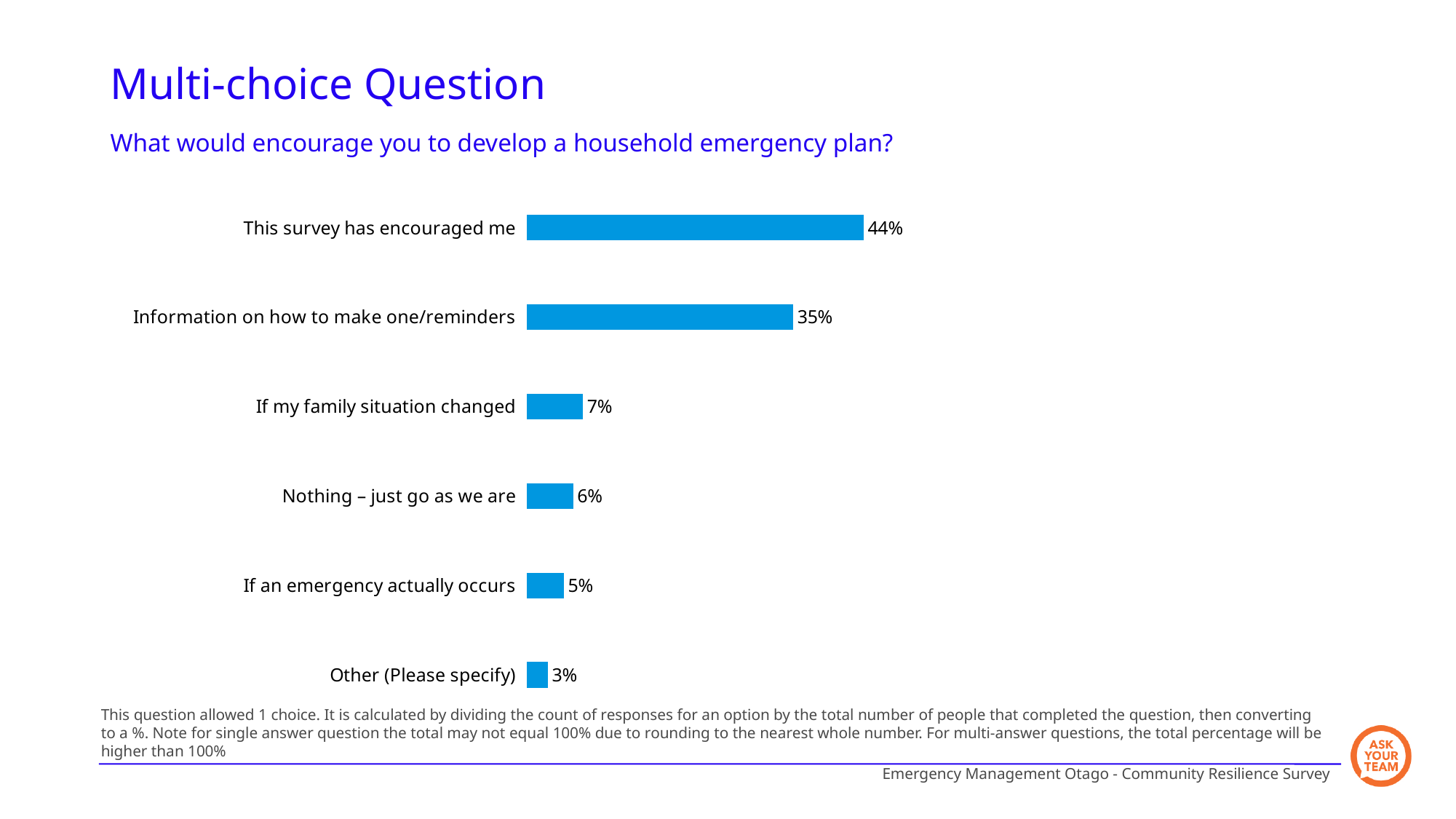
What is the value for "Information on how to make one/reminders"? 35% What percentage is shown for "If my family situation changed"? 7% What percentage of respondents chose "This survey has encouraged me"? 44% Which option has the highest percentage? This survey has encouraged me What survey question does the chart present responses to? What would encourage you to develop a household emergency plan? What is the difference between "This survey has encouraged me" and "Information on how to make one/reminders"? 9% What type of chart is shown on the slide? Bar chart Which option has the lowest percentage? Other (Please specify) What is the value for "Other (Please specify)"? 3% What is the difference between "If my family situation changed" and "If an emergency actually occurs"? 2% How many options are shown in the chart? 6 Which is larger: "Nothing – just go as we are" or "If an emergency actually occurs"? Nothing – just go as we are